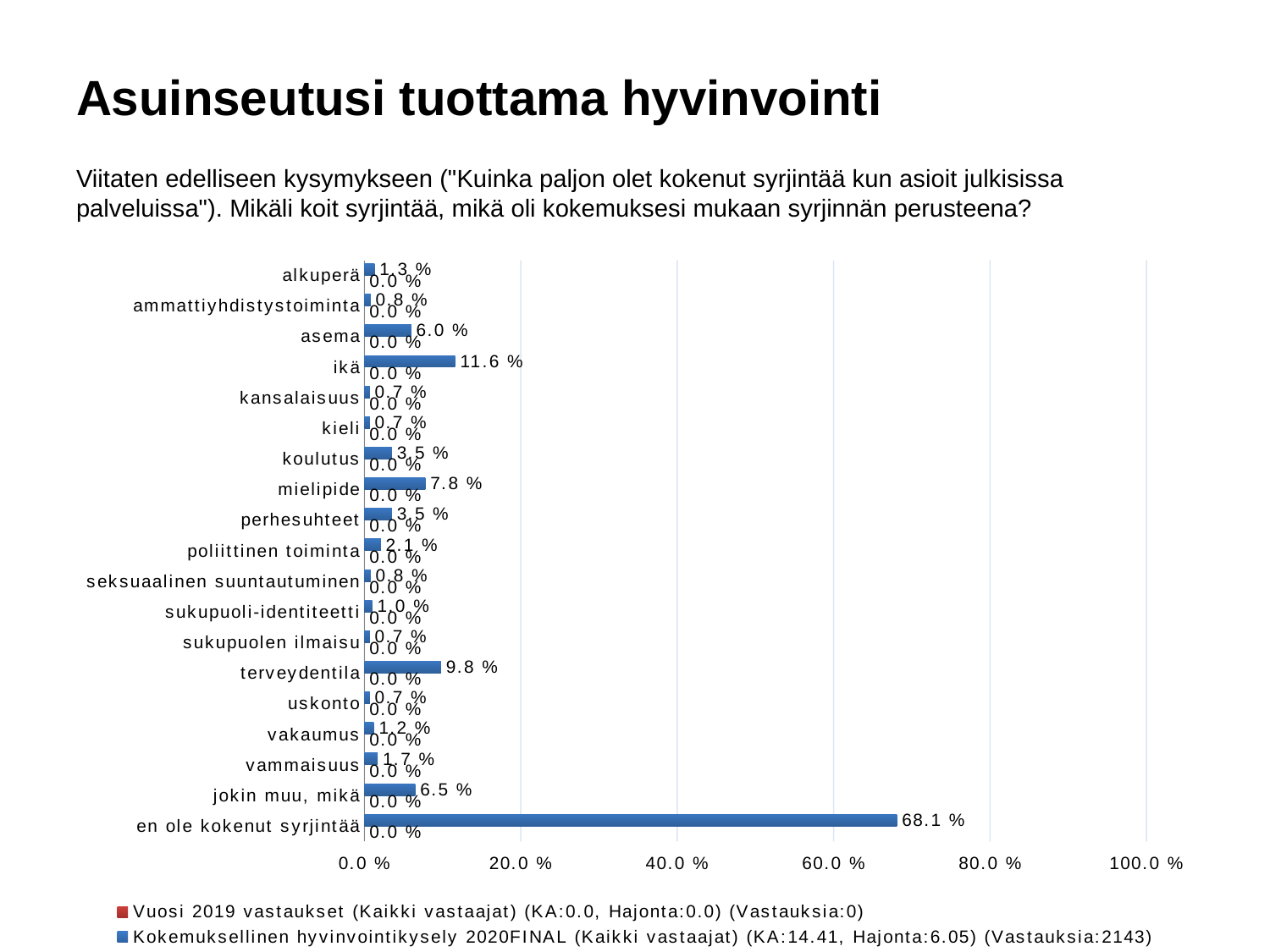
How many categories are shown on the chart? 19 What kind of chart is shown on the slide? bar chart Is the value for 'en ole kokenut syrjintää' in the Kokemuksellinen hyvinvointikysely 2020FINAL series greater or less than 60.0 %? greater What is the value for 'ikä' in the Kokemuksellinen hyvinvointikysely 2020FINAL series? 11.6 % What is the value for 'jokin muu, mikä' in the Kokemuksellinen hyvinvointikysely 2020FINAL series? 6.5 % What is the difference between the values for 'ikä' and 'asema' in the Kokemuksellinen hyvinvointikysely 2020FINAL series? 5.6 % What is the value for 'terveydentila' in the Kokemuksellinen hyvinvointikysely 2020FINAL series? 9.8 % Which category has the highest value in the Kokemuksellinen hyvinvointikysely 2020FINAL series? en ole kokenut syrjintää What is the value for 'alkuperä' in the Vuosi 2019 vastaukset series? 0.0 % What is the value for 'en ole kokenut syrjintää' in the Kokemuksellinen hyvinvointikysely 2020FINAL series? 68.1 % Which has a larger value in the Kokemuksellinen hyvinvointikysely 2020FINAL series, 'mielipide' or 'koulutus'? mielipide How many series does the legend list? 2